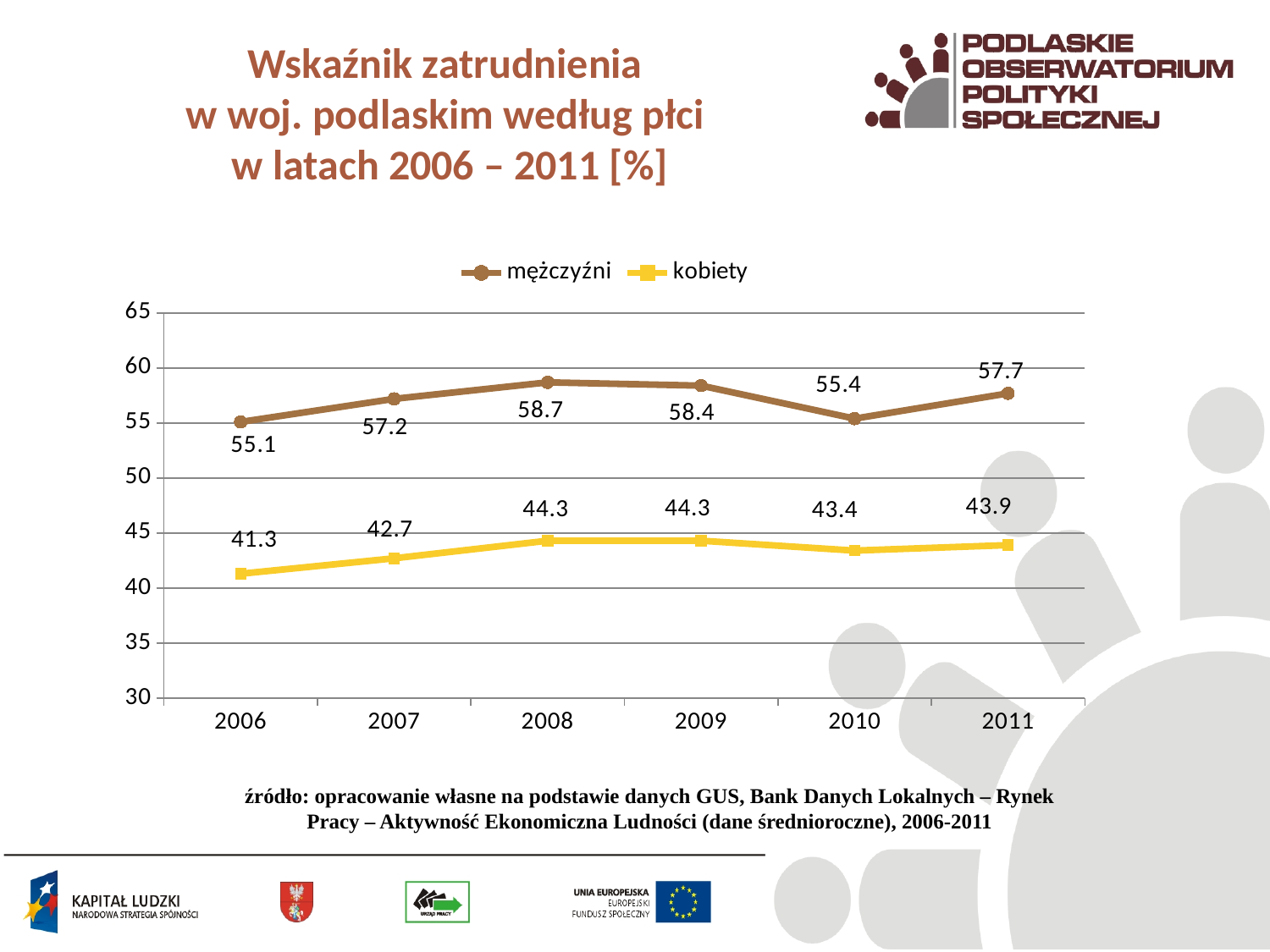
In which year is the value for kobiety highest? 2008 and 2009 What is the value for kobiety in 2006? 41.3 How many years are shown on the x axis? 6 What is the value for kobiety in 2010? 43.4 Is the value for kobiety in 2009 greater or less than 45? less Does the value for kobiety rise or fall from 2006 to 2008? rise How many series does the legend list? 2 In which year is the value for mężczyźni lowest? 2006 Which is larger: the value for mężczyźni in 2007 or in 2010? 2007 What kind of chart is shown on the slide? line chart What is the difference between the mężczyźni and kobiety values in 2011? 13.8 What is the value for mężczyźni in 2008? 58.7